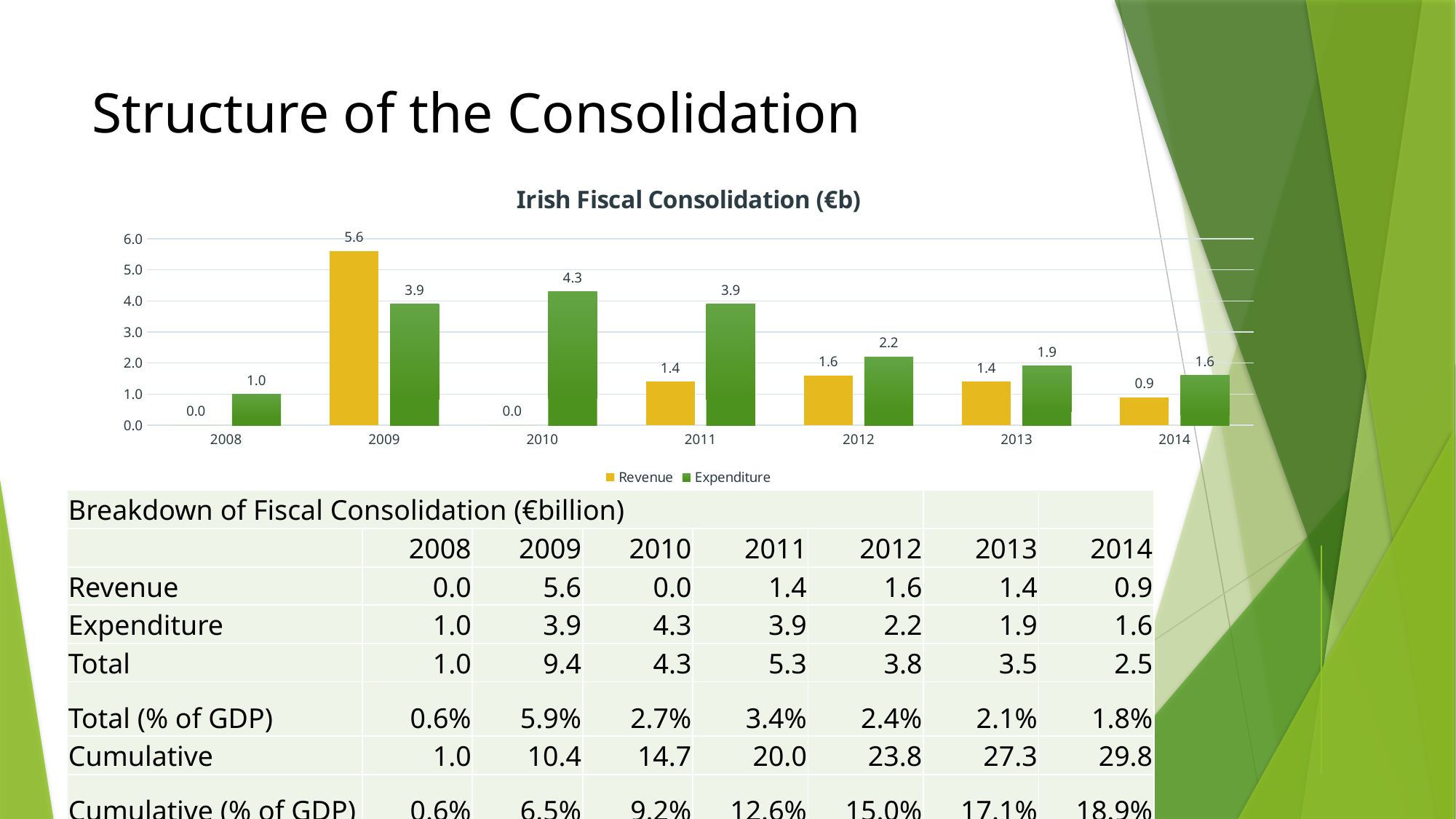
In 2012, which is larger in the Irish Fiscal Consolidation chart: Revenue or Expenditure? Expenditure Which year has the highest Expenditure value in the Irish Fiscal Consolidation chart? 2010 What kind of chart is the Irish Fiscal Consolidation chart? Bar chart What is the Revenue value for 2009 in the Irish Fiscal Consolidation chart? 5.6 What colour are the Revenue bars in the Irish Fiscal Consolidation chart? Yellow What is the Expenditure value for 2010 in the Irish Fiscal Consolidation chart? 4.3 How many years are shown on the x axis of the Irish Fiscal Consolidation chart? 7 Does the Expenditure series rise or fall from 2011 to 2014 in the Irish Fiscal Consolidation chart? Fall What is the difference between Revenue and Expenditure in 2009 in the Irish Fiscal Consolidation chart? 1.7 Which year has the lowest Expenditure value in the Irish Fiscal Consolidation chart? 2008 What is the Revenue value for 2014 in the Irish Fiscal Consolidation chart? 0.9 How many series does the legend of the Irish Fiscal Consolidation chart list? 2